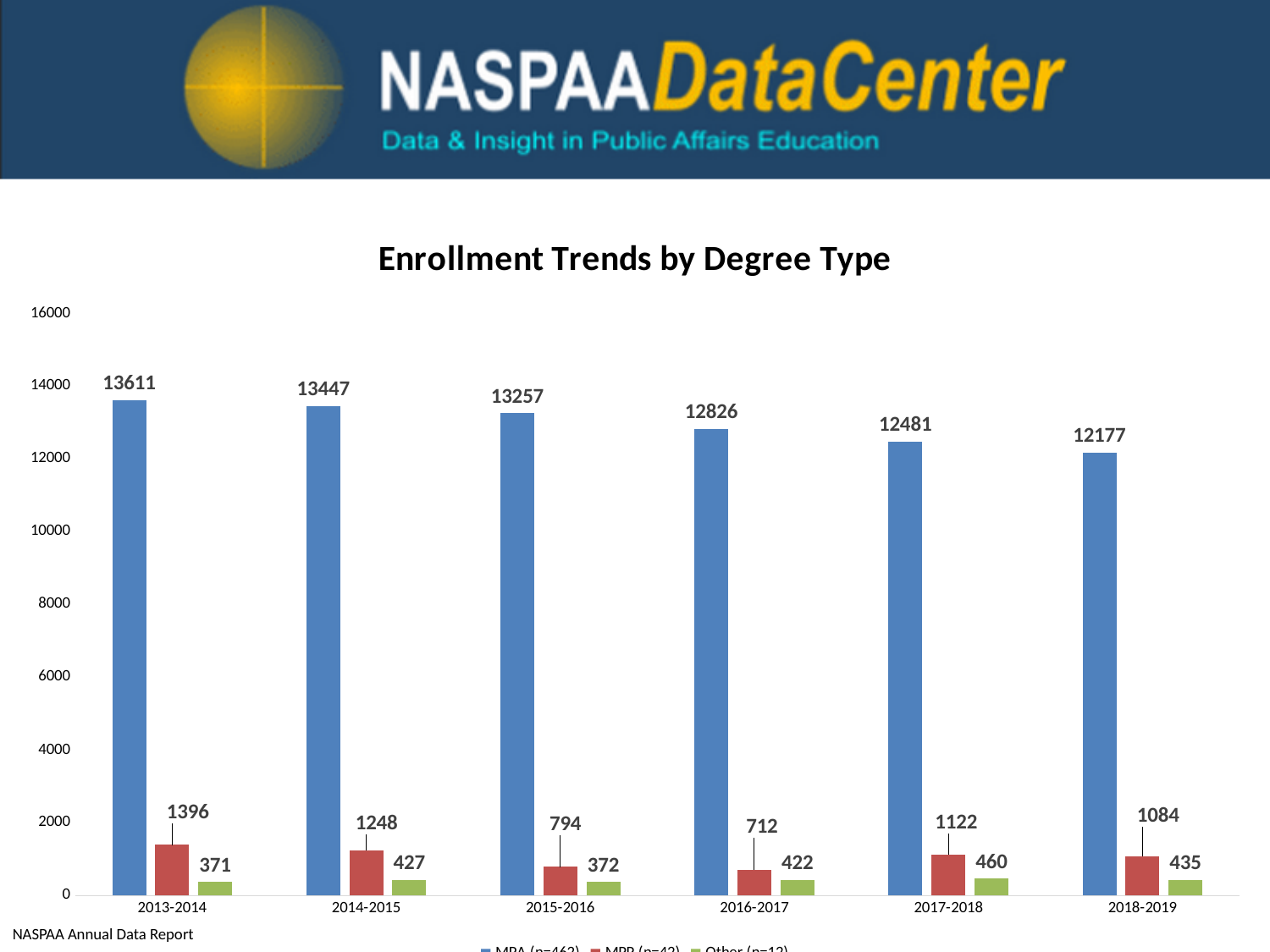
Is the value of the blue bar for 2016-2017 greater or less than 14000? less In which year is the blue bar lowest? 2018-2019 Do the blue bar values rise or fall from 2013-2014 to 2018-2019? fall What is the value of the green bar for 2017-2018? 460 In which year is the red bar highest? 2013-2014 What is the value of the red bar for 2016-2017? 712 What is the value of the blue bar for 2013-2014? 13611 How many data series are plotted in the chart? 3 What kind of chart is shown on the slide? bar chart Which is larger, the green bar for 2014-2015 or the green bar for 2015-2016? 2014-2015 How many year categories are shown on the x axis? 6 What is the difference between the blue bar values for 2013-2014 and 2018-2019? 1434